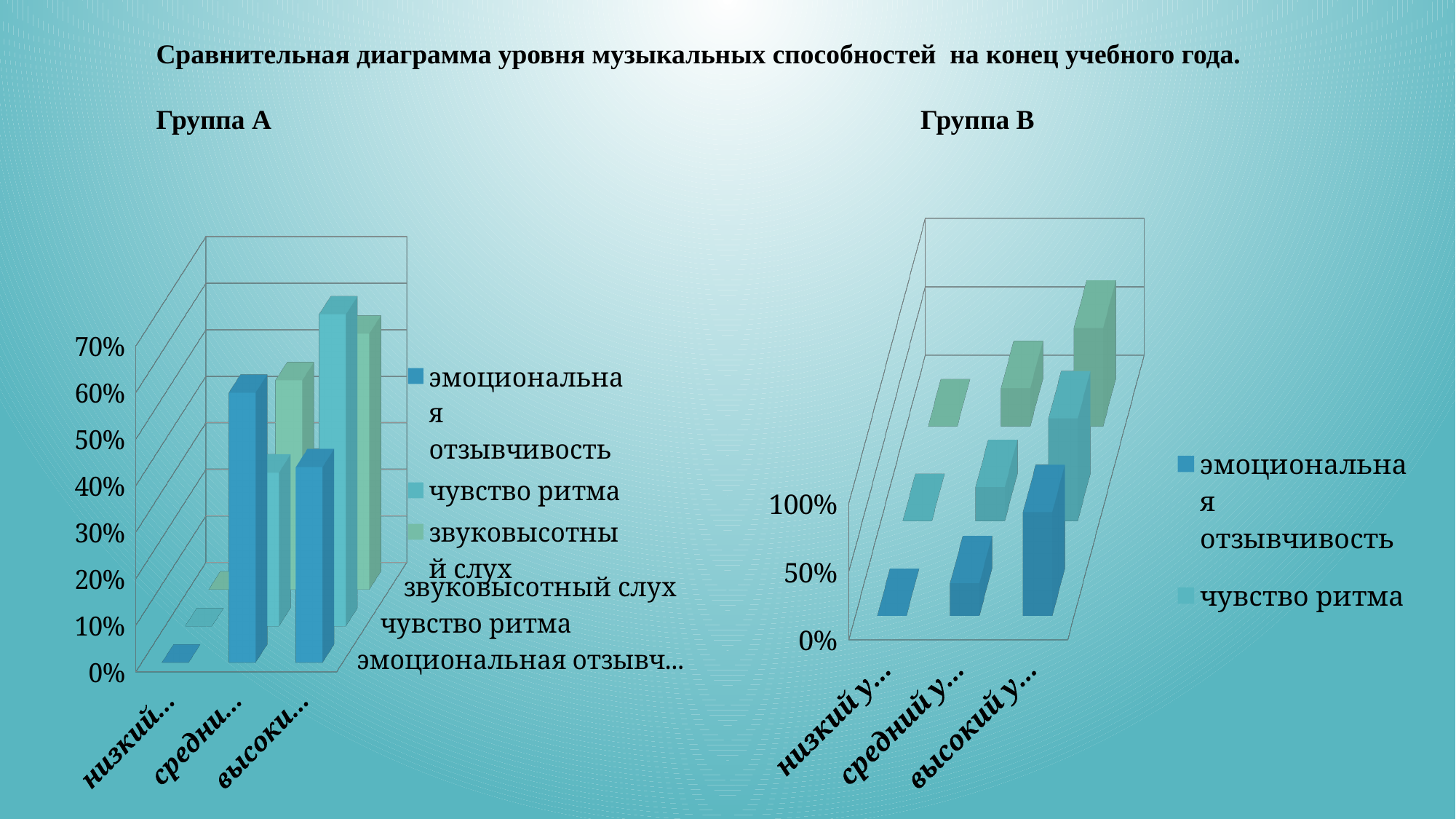
In the Группа В chart, is the value for эмоциональная отзывчивость at высокий greater or less than 50%? greater In the Группа В chart, which category has the highest value for эмоциональная отзывчивость? высокий What is the title shown above the two charts? Сравнительная диаграмма уровня музыкальных способностей на конец учебного года. In the Группа А chart, which category has the lowest value for эмоциональная отзывчивость? низкий In the Группа А chart, is the value for эмоциональная отзывчивость at низкий greater or less than 10%? less In the Группа А chart, which is larger for эмоциональная отзывчивость: средний or высокий? средний In the Группа А chart, is the value for чувство ритма at высокий greater or less than 30%? greater How many series does the legend of the Группа А chart list? 3 How many categories are shown on the x axis of the Группа В chart? 3 How many categories are shown on the x axis of the Группа А chart? 3 What kind of chart is the Группа А chart? bar chart